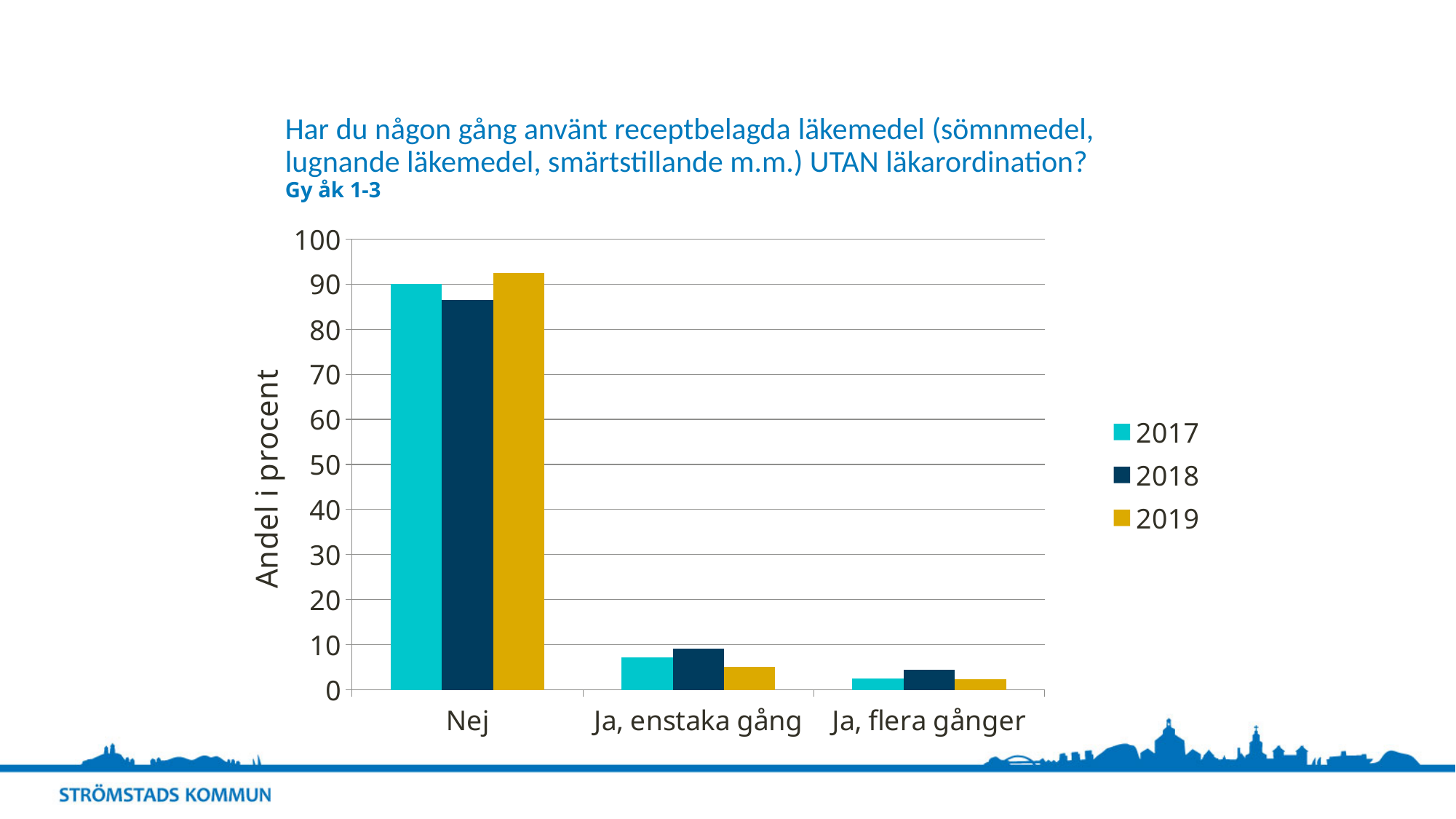
For the category Nej, which year has the highest bar? 2019 Do the values rise or fall moving from Nej to Ja, flera gånger along the x axis? fall Is the value for Nej in 2018 greater or less than 80? greater Which category has the highest values for all three years? Nej For the category Nej, which year has the lowest bar? 2018 What kind of chart is shown on the slide? bar chart For Ja, enstaka gång, which is larger: the 2018 value or the 2019 value? 2018 Which years are listed in the legend? 2017, 2018, 2019 What is the label of the y axis? Andel i procent How many series does the legend list? 3 Is the value for Ja, enstaka gång in 2019 greater or less than 10? less How many answer categories are shown on the x axis? 3